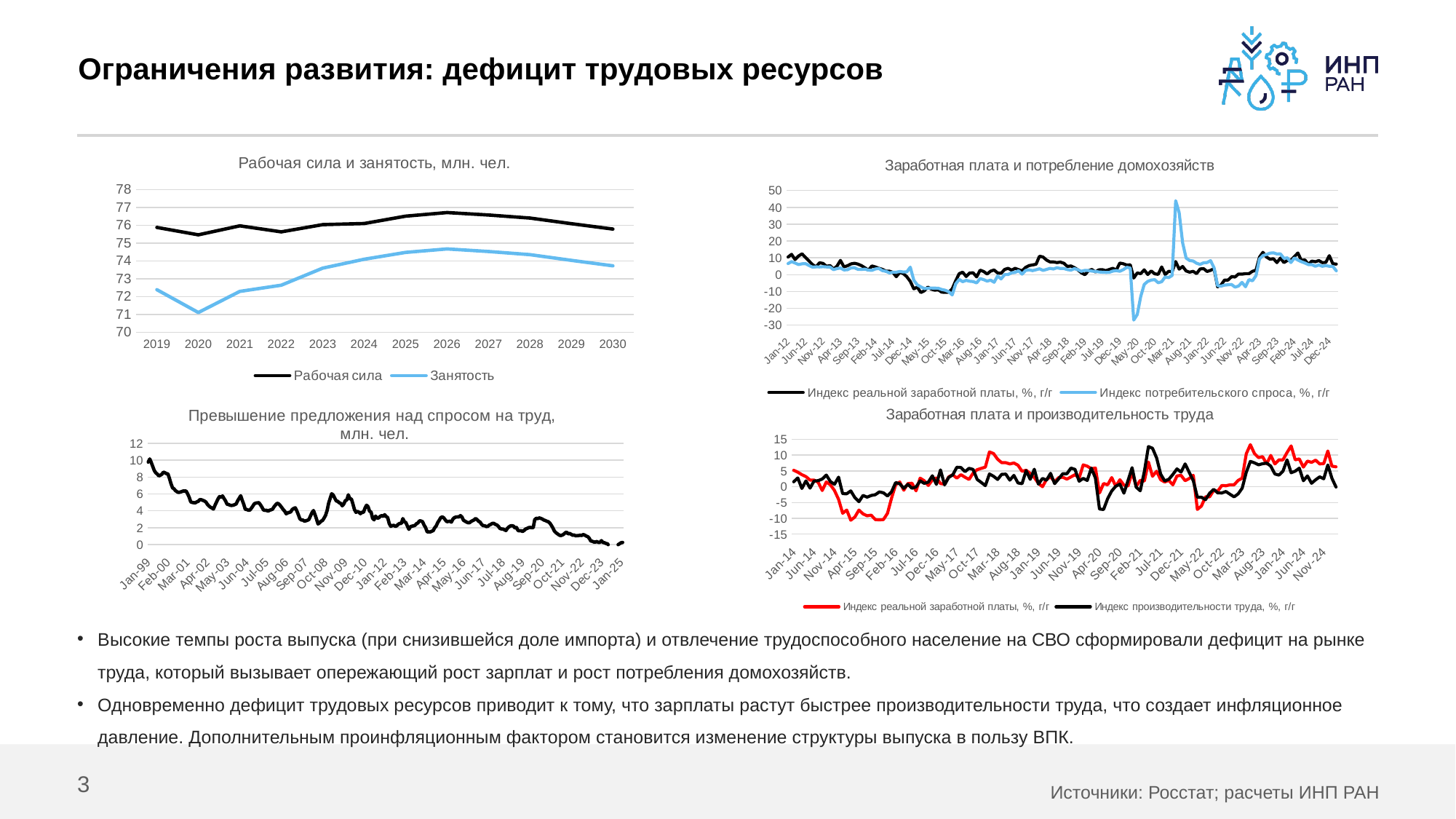
In the top-right chart "Заработная плата и потребление домохозяйств", is the peak value of "Индекс потребительского спроса, %, г/г" around Mar-21 greater or less than 40? greater In the bottom-right chart "Заработная плата и производительность труда", what colour is the line for "Индекс реальной заработной платы, %, г/г"? red In the top-left chart "Рабочая сила и занятость, млн. чел.", which series is larger in 2019, "Рабочая сила" or "Занятость"? Рабочая сила How many series does the legend of the top-left chart "Рабочая сила и занятость, млн. чел." list? 2 What kind of chart is the top-left chart titled "Рабочая сила и занятость, млн. чел."? line chart In the top-left chart "Рабочая сила и занятость, млн. чел.", in which year is the "Занятость" series lowest? 2020 How many series does the legend of the bottom-right chart "Заработная плата и производительность труда" list? 2 In the top-left chart "Рабочая сила и занятость, млн. чел.", in which year is the "Рабочая сила" series highest? 2026 In the bottom-left chart "Превышение предложения над спросом на труд, млн. чел.", do the values generally rise or fall from Jan-99 to Jan-25? fall In the bottom-left chart "Превышение предложения над спросом на труд, млн. чел.", is the value at Jan-99 greater or less than 8? greater How many years are shown on the x axis of the top-left chart "Рабочая сила и занятость, млн. чел."? 12 In the top-left chart "Рабочая сила и занятость, млн. чел.", is the value of "Занятость" in 2020 greater or less than 72? less